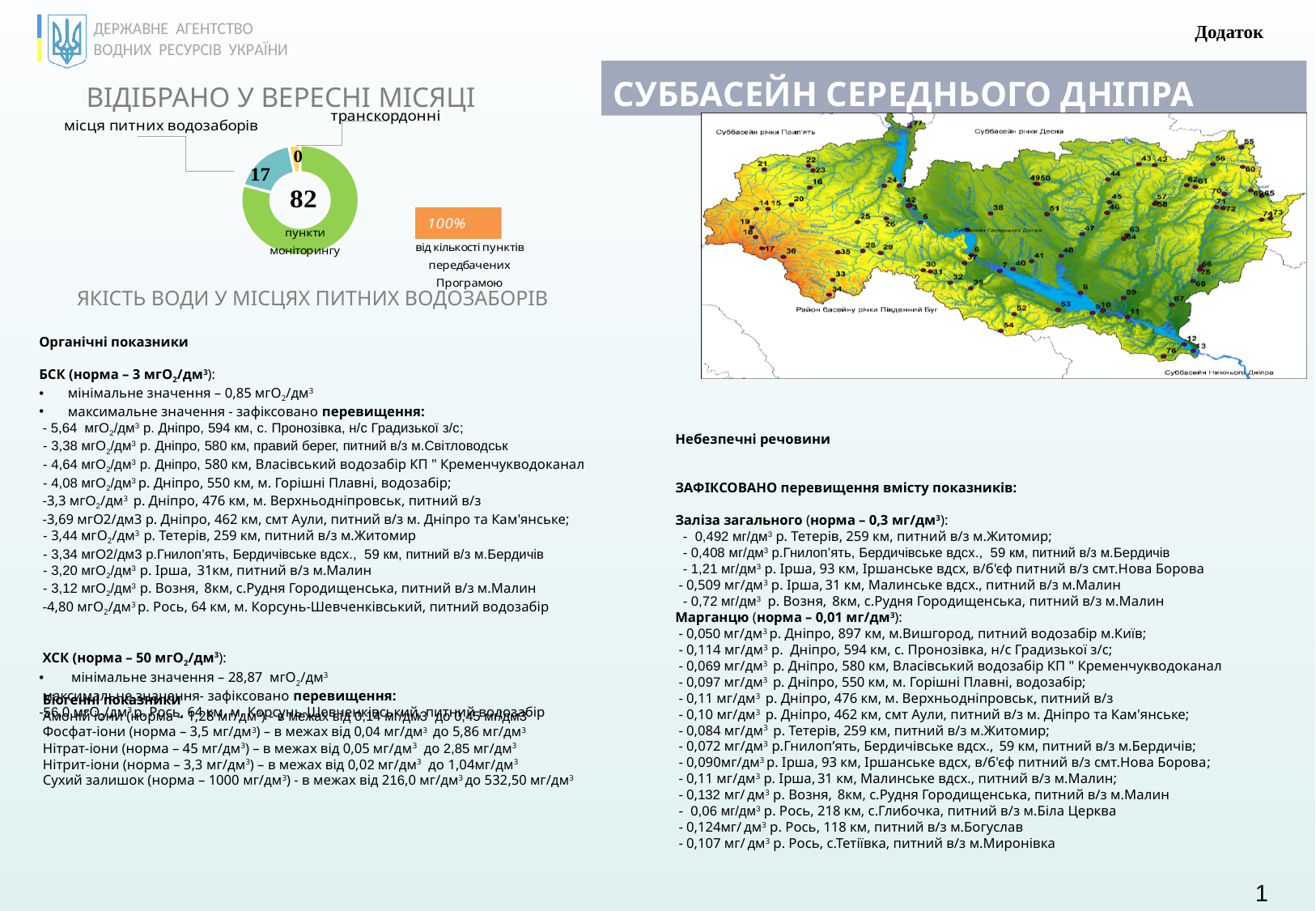
In the donut chart under "ВІДІБРАНО У ВЕРЕСНІ МІСЯЦІ", what colour is the largest segment? Green What is the heading above the donut chart on the left of the slide? ВІДІБРАНО У ВЕРЕСНІ МІСЯЦІ In the donut chart under "ВІДІБРАНО У ВЕРЕСНІ МІСЯЦІ", what value is shown for "транскордонні"? 0 How many labelled categories does the donut chart under "ВІДІБРАНО У ВЕРЕСНІ МІСЯЦІ" show? 3 In the donut chart under "ВІДІБРАНО У ВЕРЕСНІ МІСЯЦІ", what number is shown in the centre for "пункти моніторингу"? 82 What kind of chart is shown under the heading "ВІДІБРАНО У ВЕРЕСНІ МІСЯЦІ"? Donut (pie) chart In the donut chart under "ВІДІБРАНО У ВЕРЕСНІ МІСЯЦІ", what value is shown for "місця питних водозаборів"? 17 In the donut chart under "ВІДІБРАНО У ВЕРЕСНІ МІСЯЦІ", what is the difference between the value for "пункти моніторингу" and the value for "місця питних водозаборів"? 65 In the donut chart under "ВІДІБРАНО У ВЕРЕСНІ МІСЯЦІ", which category has the highest value? пункти моніторингу In the donut chart under "ВІДІБРАНО У ВЕРЕСНІ МІСЯЦІ", which is larger: "місця питних водозаборів" or "транскордонні"? місця питних водозаборів In the donut chart under "ВІДІБРАНО У ВЕРЕСНІ МІСЯЦІ", which category has the lowest value? транскордонні